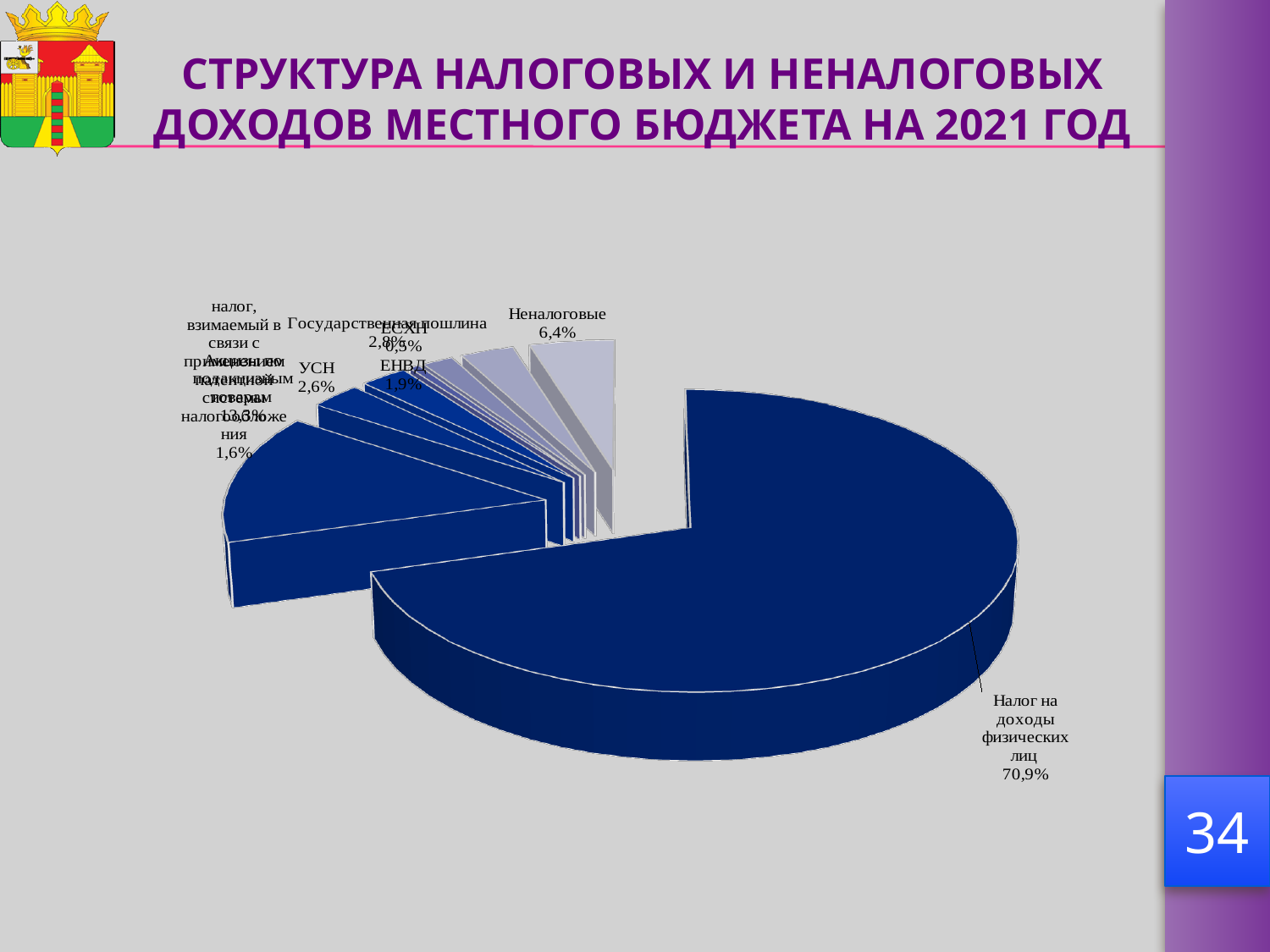
By how many percentage points does "Налог на доходы физических лиц" exceed "Неналоговые"? 64,5% Which slice of the pie is the largest? Налог на доходы физических лиц What value is shown for "Государственная пошлина"? 2,8% What is the title of the slide containing the pie chart? СТРУКТУРА НАЛОГОВЫХ И НЕНАЛОГОВЫХ ДОХОДОВ МЕСТНОГО БЮДЖЕТА НА 2021 ГОД What kind of chart is shown on the slide? pie chart What share of the pie is labelled for "Налог на доходы физических лиц"? 70,9% Which labelled slice of the pie is the smallest? ЕСХН What value is shown for the "Неналоговые" slice? 6,4% What value is shown for "ЕНВД"? 1,9% Which is larger, the "Неналоговые" slice or the "Государственная пошлина" slice? Неналоговые What value is shown for "ЕСХН"? 0,5% What value is shown for "УСН"? 2,6%